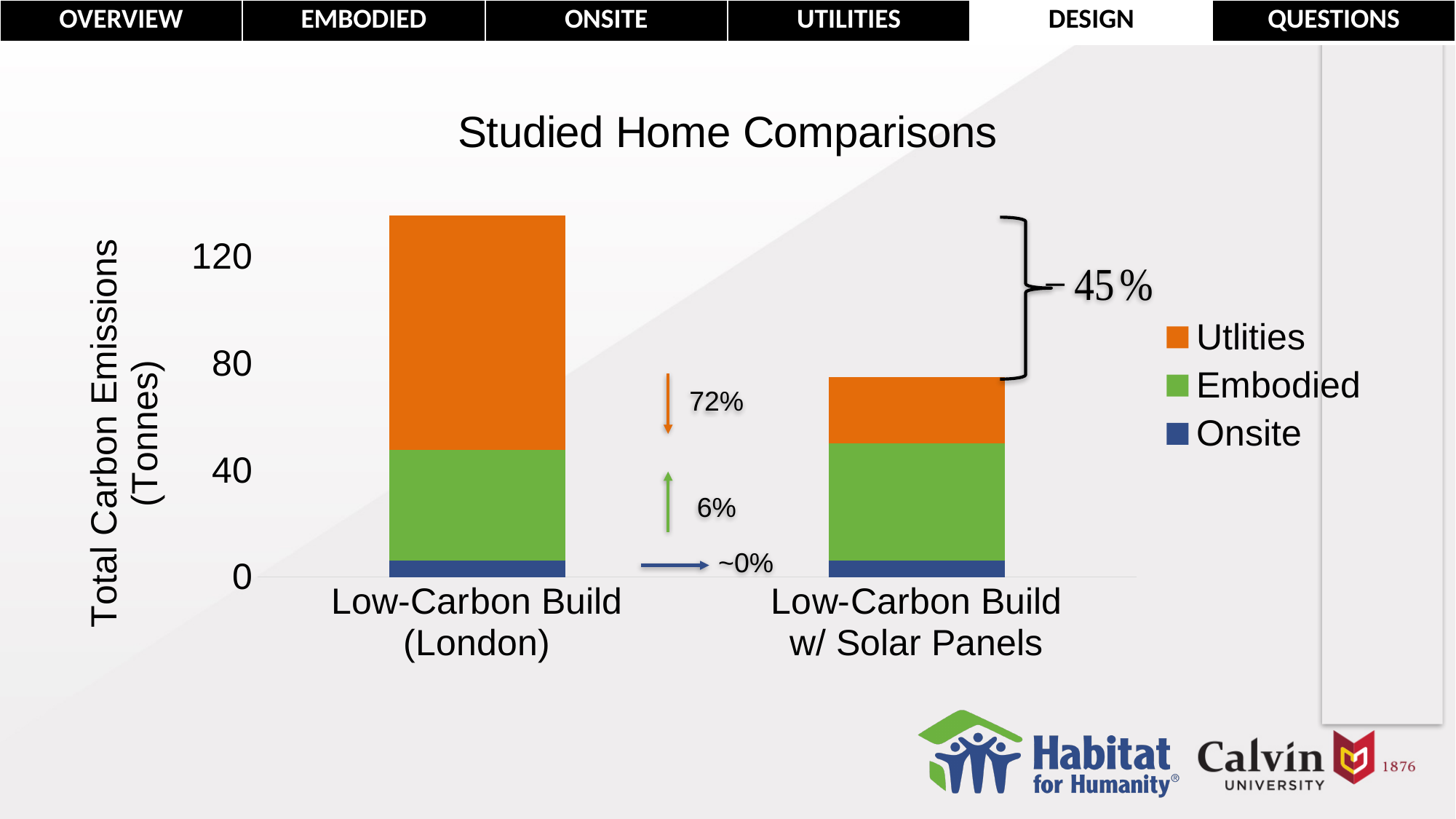
Is the total for Low-Carbon Build w/ Solar Panels greater or less than 80? less What is the label on the y axis? Total Carbon Emissions (Tonnes) How many categories are shown on the x axis? 2 Which category has the higher total carbon emissions? Low-Carbon Build (London) Is the total for Low-Carbon Build (London) greater or less than 120? greater Which series is shown in orange in the legend? Utlities What kind of chart is shown on the slide? stacked bar chart What is the title of the chart? Studied Home Comparisons Do the total emissions rise or fall from Low-Carbon Build (London) to Low-Carbon Build w/ Solar Panels? fall How many series does the legend list? 3 Which category has the lower total carbon emissions? Low-Carbon Build w/ Solar Panels Is the Utlities segment for Low-Carbon Build w/ Solar Panels greater or less than 40? less